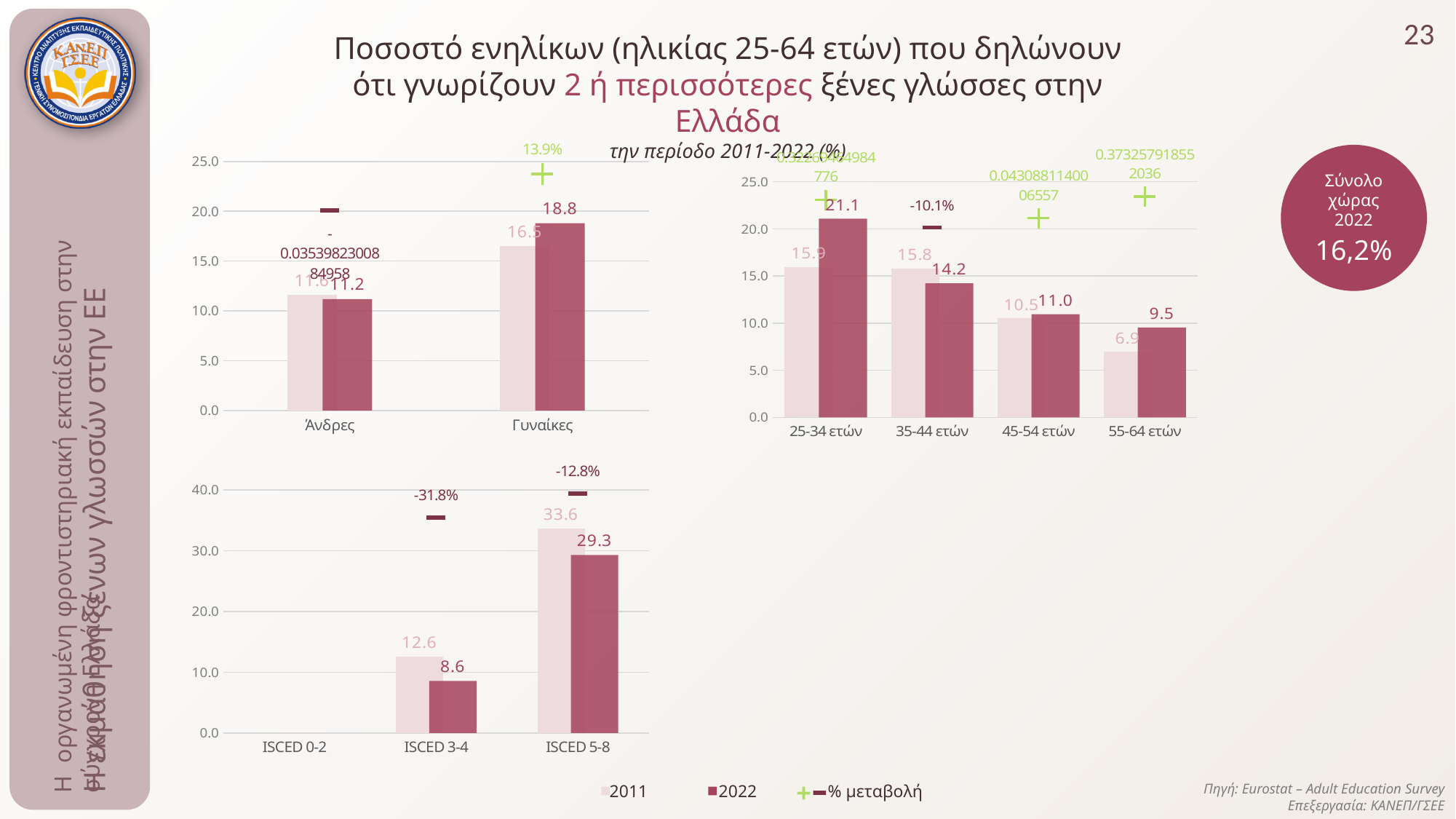
In the top-left chart (by gender), what is the 2022 value for Άνδρες? 11.2 In the bottom-left chart (by ISCED level), what is the 2011 value for ISCED 5-8? 33.6 How many age-group categories are shown on the x axis of the top-right chart? 4 In the top-right chart (by age group), which age group has the lowest 2011 value? 55-64 ετών In the top-left chart (by gender), what is the 2022 value for Γυναίκες? 18.8 In the bottom-left chart (by ISCED level), what is the difference between the 2011 and 2022 values for ISCED 3-4? 4.0 In the bottom-left chart (by ISCED level), what percentage change is shown for ISCED 5-8? -12.8% In the top-right chart (by age group), what is the difference between the 2022 and 2011 values for 55-64 ετών? 2.6 In the top-right chart (by age group), is the 2011 value for 35-44 ετών larger or smaller than its 2022 value? larger What type of chart is the top-right chart (by age group)? Bar chart In the top-right chart (by age group), what is the 2022 value for 25-34 ετών? 21.1 In the top-left chart (by gender), what is the 2011 value for Γυναίκες? 16.5